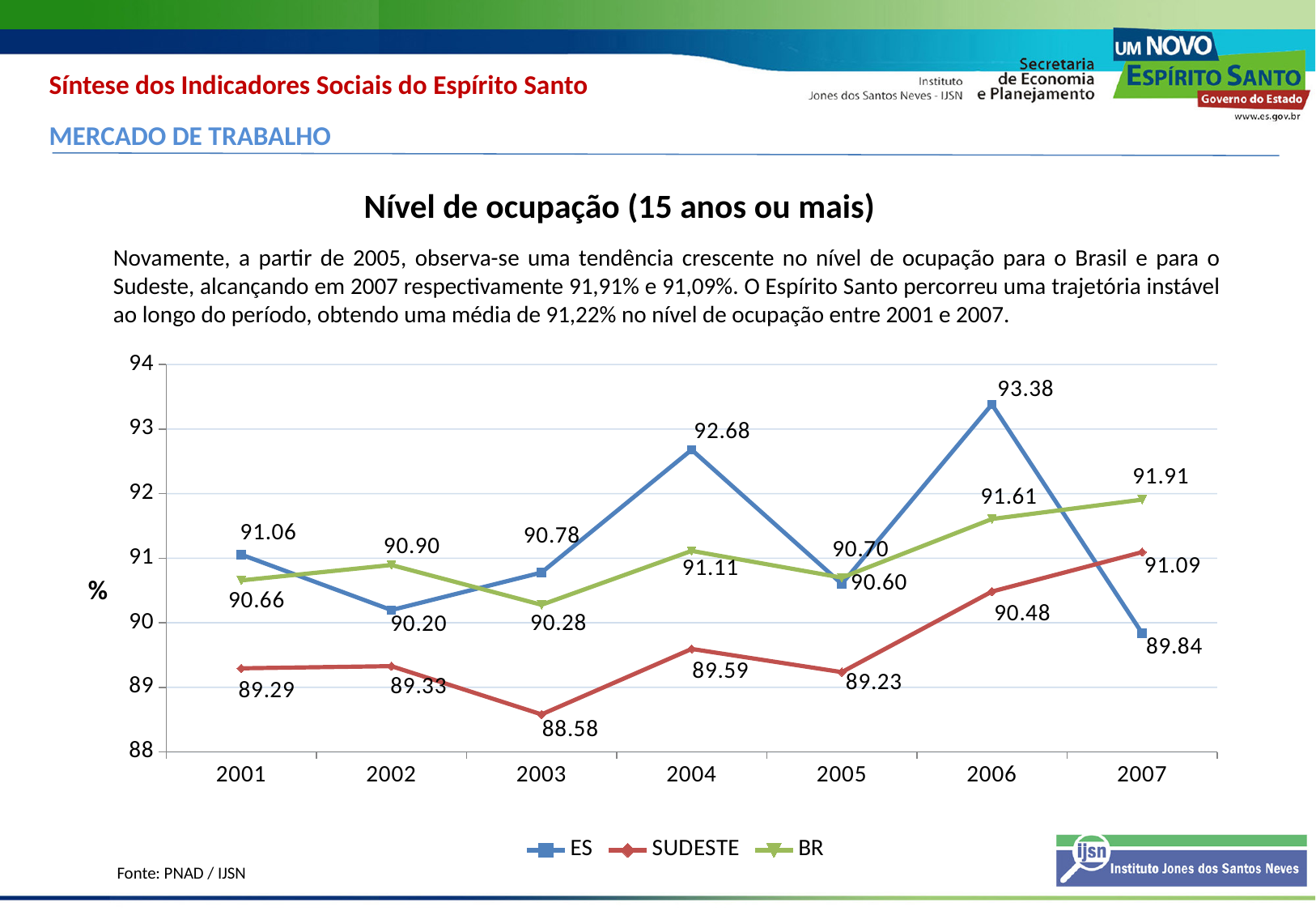
In which year does the ES series reach its highest value? 2006 Which is larger in 2007, the ES value or the SUDESTE value? SUDESTE How many series does the legend list? 3 What is the value for SUDESTE in 2003? 88.58 Does the BR series rise or fall from 2005 to 2007? Rise What is the value for BR in 2007? 91.91 What kind of chart is shown on the slide? Line chart What is the difference between the BR value and the SUDESTE value in 2007? 0.82 What is the value for ES in 2006? 93.38 In which year does the SUDESTE series have its lowest value? 2003 Is the value for ES in 2004 greater or less than 92? greater How many years are shown on the x axis? 7